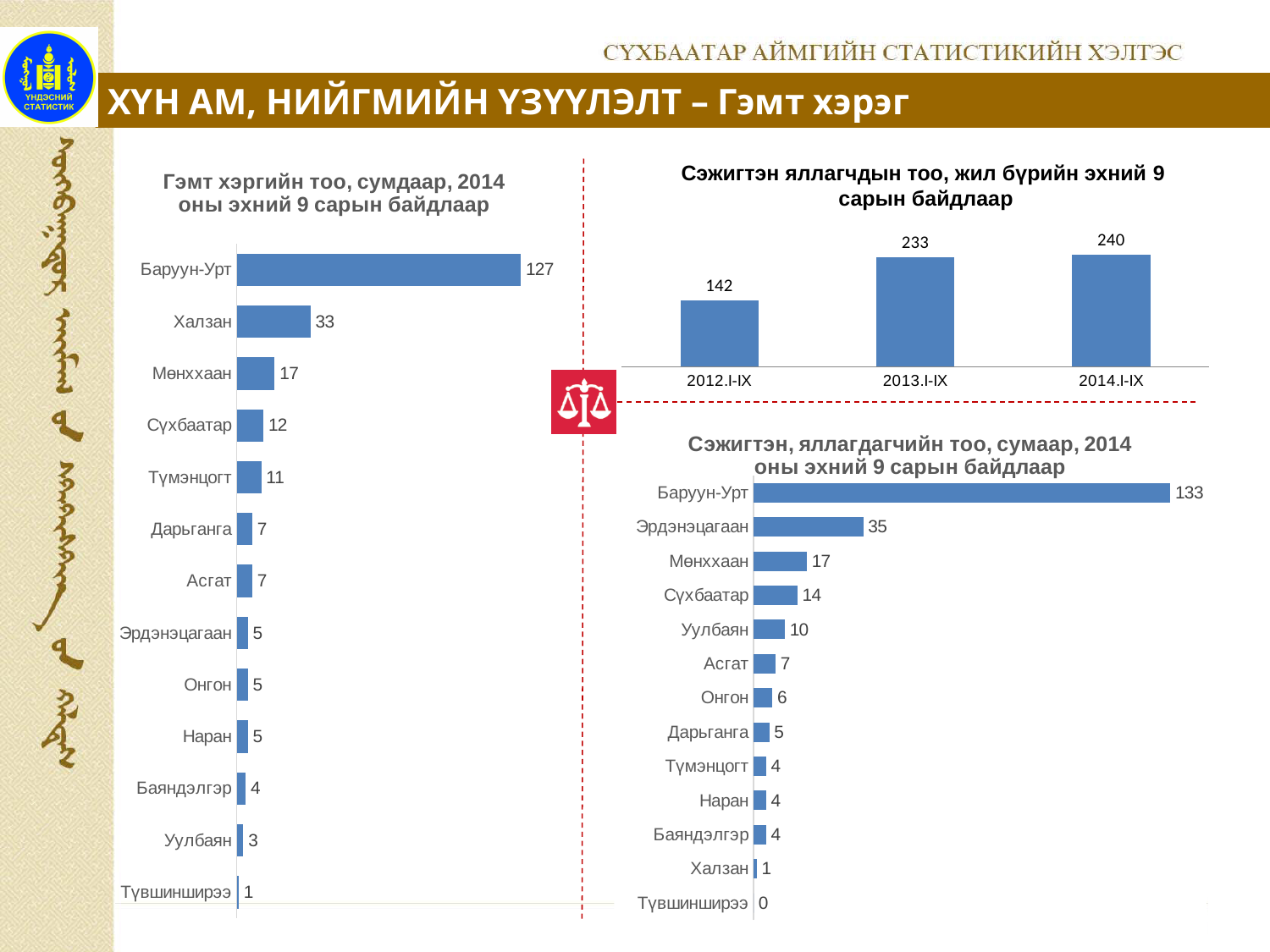
In the bottom-right chart 'Сэжигтэн, яллагдагчийн тоо, сумаар', what is the value for Түвшинширээ? 0 In the left chart 'Гэмт хэргийн тоо, сумдаар', which category has the lowest value? Түвшинширээ In the top-right chart 'Сэжигтэн яллагчдын тоо', what is the difference between 2013.I-IX and 2012.I-IX? 91 In the bottom-right chart 'Сэжигтэн, яллагдагчийн тоо, сумаар', what is the value for Эрдэнэцагаан? 35 How many categories are shown in the left chart 'Гэмт хэргийн тоо, сумдаар'? 13 In the bottom-right chart 'Сэжигтэн, яллагдагчийн тоо, сумаар', which is larger, Уулбаян or Асгат? Уулбаян In the top-right chart 'Сэжигтэн яллагчдын тоо', do the values rise or fall from 2012.I-IX to 2014.I-IX? rise In the left chart 'Гэмт хэргийн тоо, сумдаар, 2014 оны эхний 9 сарын байдлаар', what is the value for Баруун-Урт? 127 In the top-right chart 'Сэжигтэн яллагчдын тоо, жил бүрийн эхний 9 сарын байдлаар', what is the value for 2012.I-IX? 142 What kind of chart is the top-right chart 'Сэжигтэн яллагчдын тоо, жил бүрийн эхний 9 сарын байдлаар'? bar chart In the top-right chart 'Сэжигтэн яллагчдын тоо', which year has the highest value? 2014.I-IX In the left chart 'Гэмт хэргийн тоо, сумдаар', what is the difference between Халзан and Мөнххаан? 16